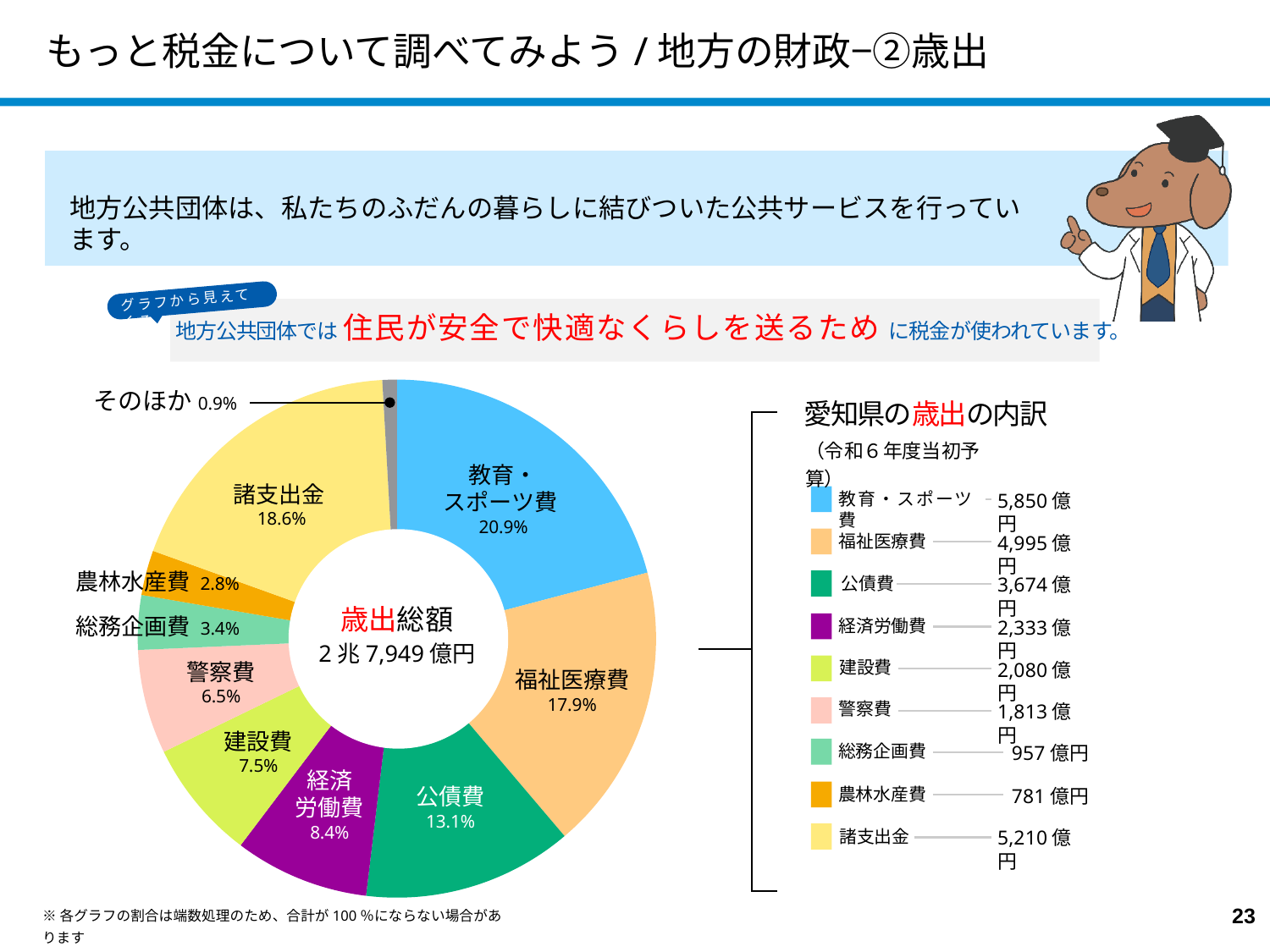
Which category has the smallest share of the expenditure? そのほか How many categories are shown in the pie chart? 10 Which category has the largest share of the expenditure? 教育・スポーツ費 What share of the expenditure does 教育・スポーツ費 account for? 20.9% What kind of chart is shown on the slide? Pie chart (donut) What is the total expenditure amount shown in the centre of the chart? 2兆7,949億円 Which is larger, the share for 公債費 or the share for 経済労働費? 公債費 What is the difference in percentage points between 諸支出金 and 福祉医療費? 0.7 What is the title of the breakdown shown on the right of the chart? 愛知県の歳出の内訳 According to the legend, what is the amount for 警察費? 1,813億円 What percentage is shown for 福祉医療費? 17.9% How many entries does the legend on the right list? 9